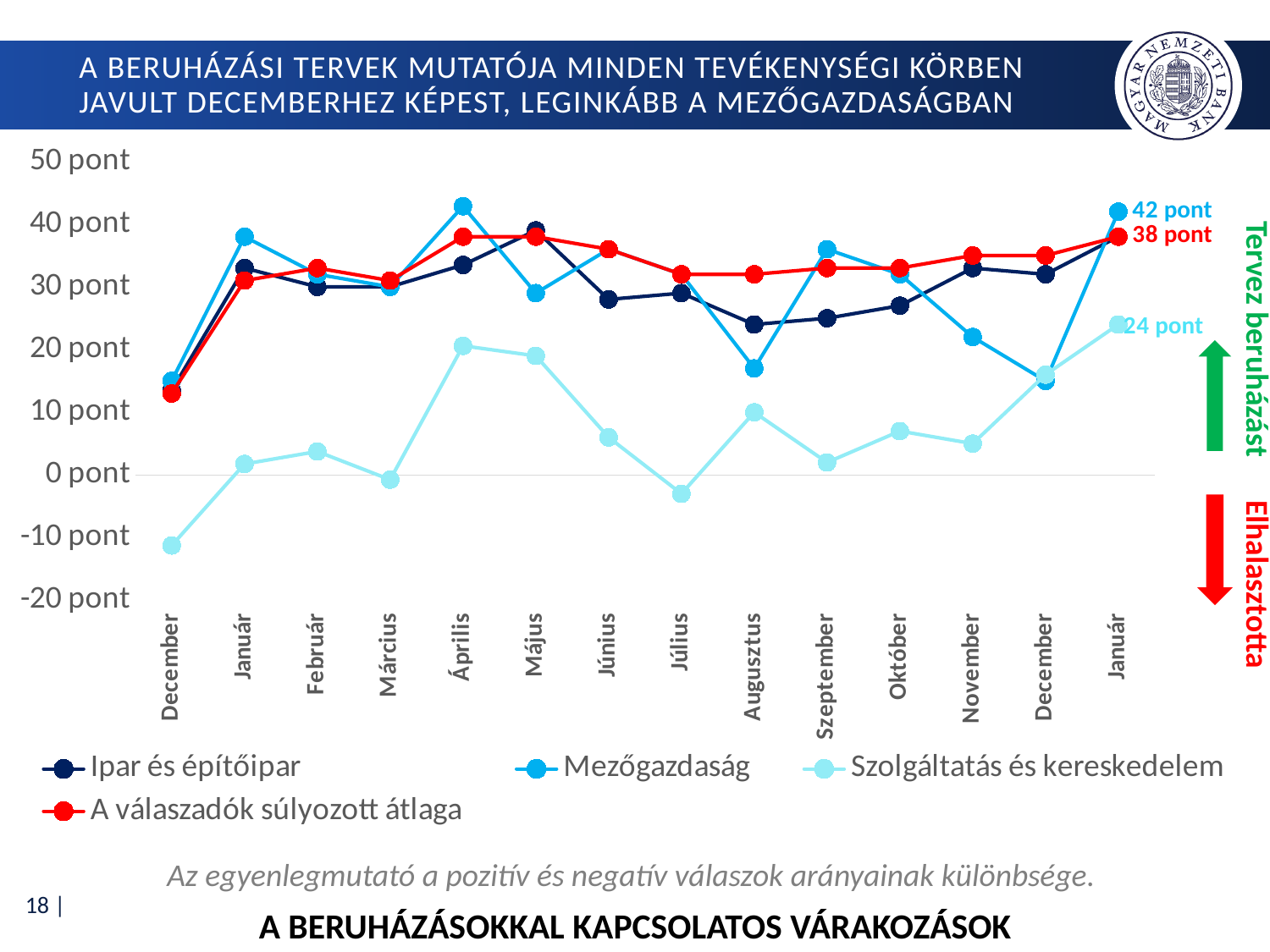
Is the value for Mezőgazdaság in Április greater or less than 40 pont? greater At the final Január point, what is the difference between Mezőgazdaság and A válaszadók súlyozott átlaga? 4 pont What is the value of A válaszadók súlyozott átlaga at the final Január point? 38 pont At the final Január point, what is the difference between Mezőgazdaság and Szolgáltatás és kereskedelem? 18 pont What is the value of Mezőgazdaság at the final Január point? 42 pont How many points are there along the x axis? 14 What kind of chart is shown on the slide? line chart At the final Január point, which is larger: Mezőgazdaság or Szolgáltatás és kereskedelem? Mezőgazdaság What is the value of Szolgáltatás és kereskedelem at the final Január point? 24 pont Which series is drawn in red? A válaszadók súlyozott átlaga How many series does the legend list? 4 Is the value for Szolgáltatás és kereskedelem in the first December greater or less than 0 pont? less